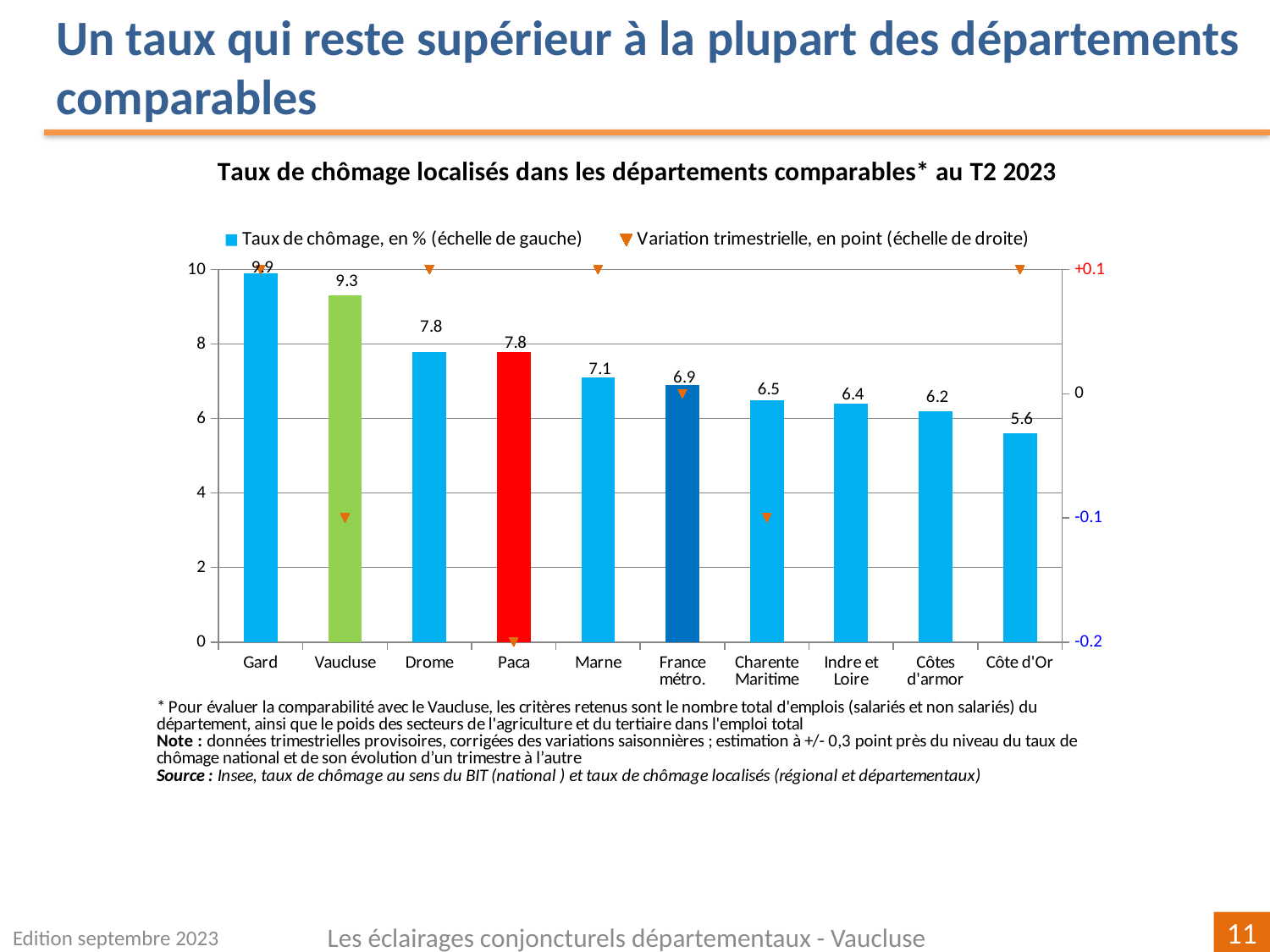
What is the difference between the unemployment rate of Gard and that of Vaucluse? 0.6 What is the unemployment rate shown for Côte d'Or? 5.6 How many series does the legend list? 2 What is the unemployment rate (Taux de chômage) for Vaucluse? 9.3 Do the unemployment rate bars rise or fall from left to right along the x axis? Fall How many categories (departments/regions) are shown on the x axis? 10 Which department has the highest unemployment rate on the chart? Gard What is the unemployment rate shown for France métro.? 6.9 Which has a higher unemployment rate, Marne or Charente Maritime? Marne Which category has the lowest unemployment rate on the chart? Côte d'Or What kind of chart is used to show the unemployment rates? Bar chart What is the quarterly variation (Variation trimestrielle) shown for Paca on the right-hand scale? -0.2